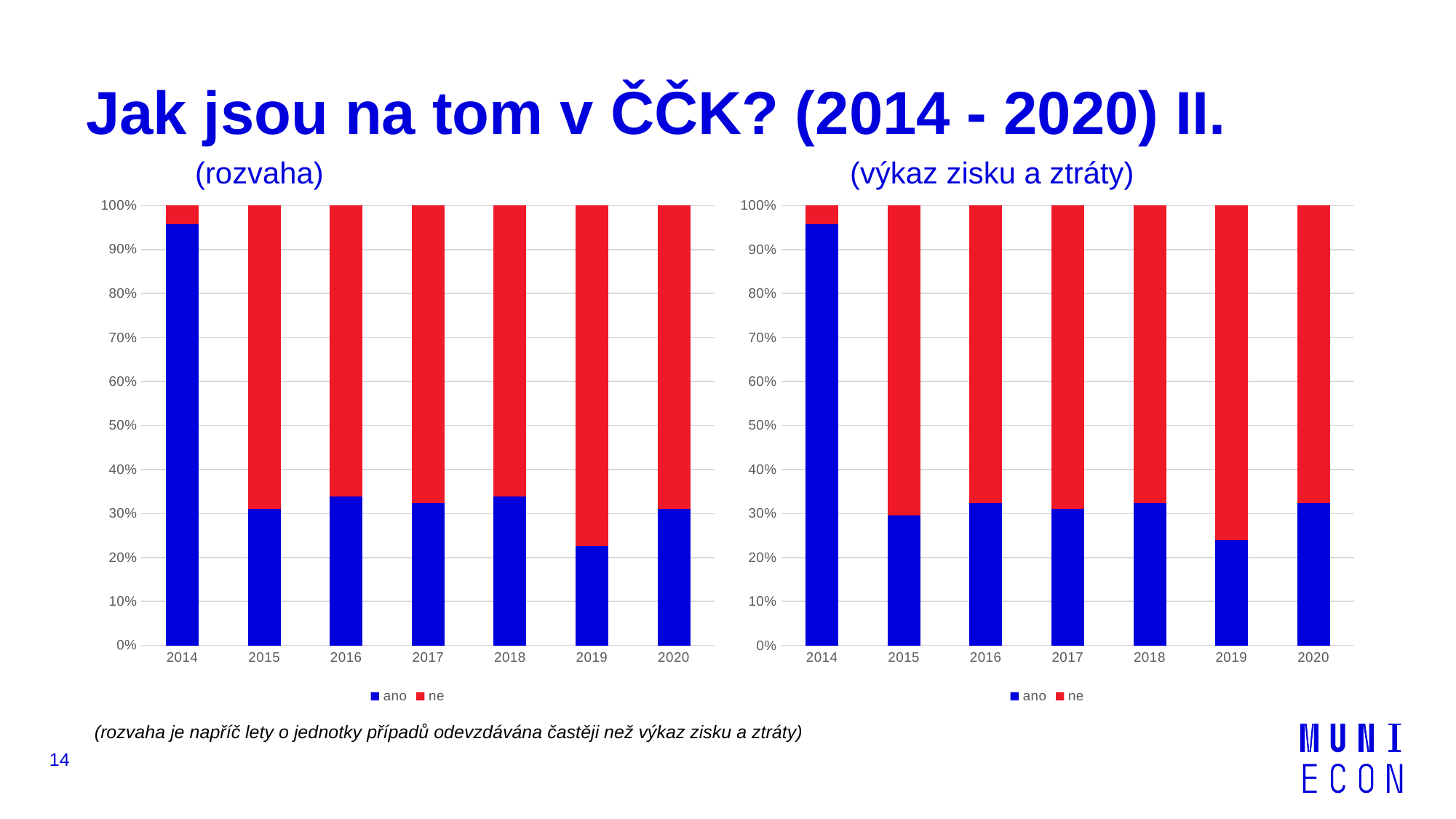
In the left chart (rozvaha), which year has the highest share of 'ano'? 2014 How many series does the legend of the left chart (rozvaha) list? 2 What are the two legend entries of the right chart (výkaz zisku a ztráty)? ano, ne In the left chart (rozvaha), which year has the lowest share of 'ano'? 2019 What kind of chart is the left chart (rozvaha)? stacked bar chart In the right chart (výkaz zisku a ztráty), which year has the larger 'ne' share, 2014 or 2019? 2019 How many years are shown on the x axis of the right chart (výkaz zisku a ztráty)? 7 In the right chart (výkaz zisku a ztráty), is the 'ano' share for 2019 greater or less than 20%? greater In the left chart (rozvaha), is the 'ano' share for 2014 greater or less than 90%? greater In the right chart (výkaz zisku a ztráty), which year has the lowest share of 'ano'? 2019 In the left chart (rozvaha), is the 'ano' share for 2019 greater or less than 30%? less In the right chart (výkaz zisku a ztráty), which year has the highest share of 'ano'? 2014